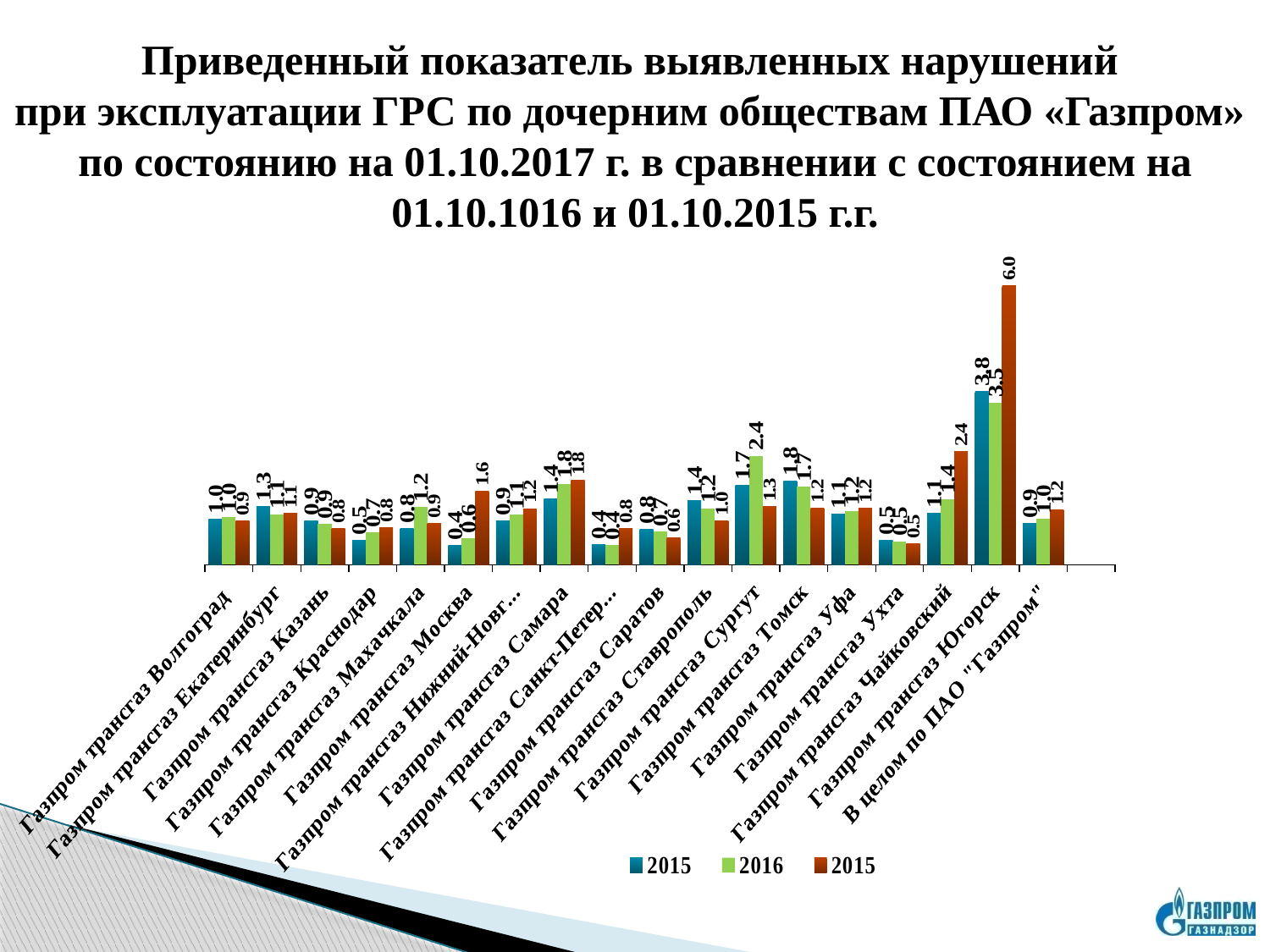
What is the 2016 value for Газпром трансгаз Сургут? 2.4 Which category has the highest 2016 value? Газпром трансгаз Югорск For Газпром трансгаз Югорск, what is the difference between the third (brown) bar and the first (teal) bar? 2.2 What is the 2016 value for Газпром трансгаз Ухта? 0.5 What kind of chart is shown on the slide? Bar chart How many series does the legend list? 3 How many categories (subsidiaries, including the overall PAO Gazprom total) are shown on the x axis? 18 What is the 2016 value for В целом по ПАО "Газпром"? 1.0 What are the legend entries, in order? 2015, 2016, 2015 Which has the larger 2016 value: Газпром трансгаз Сургут or Газпром трансгаз Чайковский? Газпром трансгаз Сургут Which category has the highest bar on the chart? Газпром трансгаз Югорск What is the value of the third (brown) bar for Газпром трансгаз Югорск? 6.0